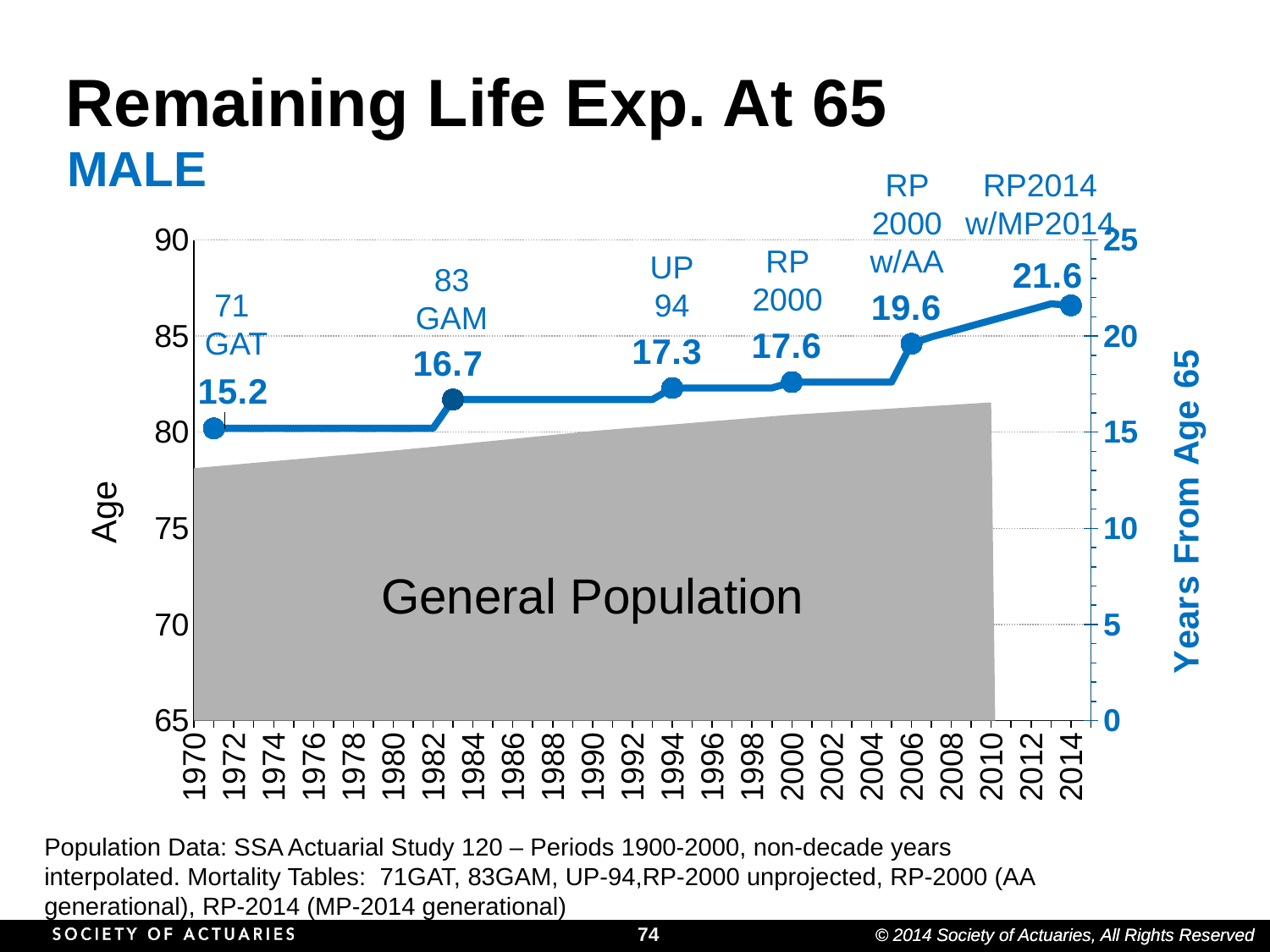
Which mortality table has the highest labeled remaining life expectancy value? RP2014 w/MP2014 What is the difference between the RP 2000 w/AA value and the RP 2000 value? 2.0 Which is larger, the value for UP 94 or the value for 83 GAM? UP 94 What value is labeled for the 83 GAM point on the line? 16.7 Does the mortality table line rise or fall from 1970 to 2014? rise Which mortality table has the lowest labeled remaining life expectancy value? 71 GAT What is the remaining life expectancy value labeled for the 71 GAT mortality table? 15.2 What is the label on the right-hand vertical axis? Years From Age 65 What value is labeled for the RP 2000 w/AA point? 19.6 What is the difference between the RP2014 w/MP2014 value and the 71 GAT value? 6.4 How many labeled data points are on the mortality table line? 6 What value is labeled for the UP 94 point? 17.3